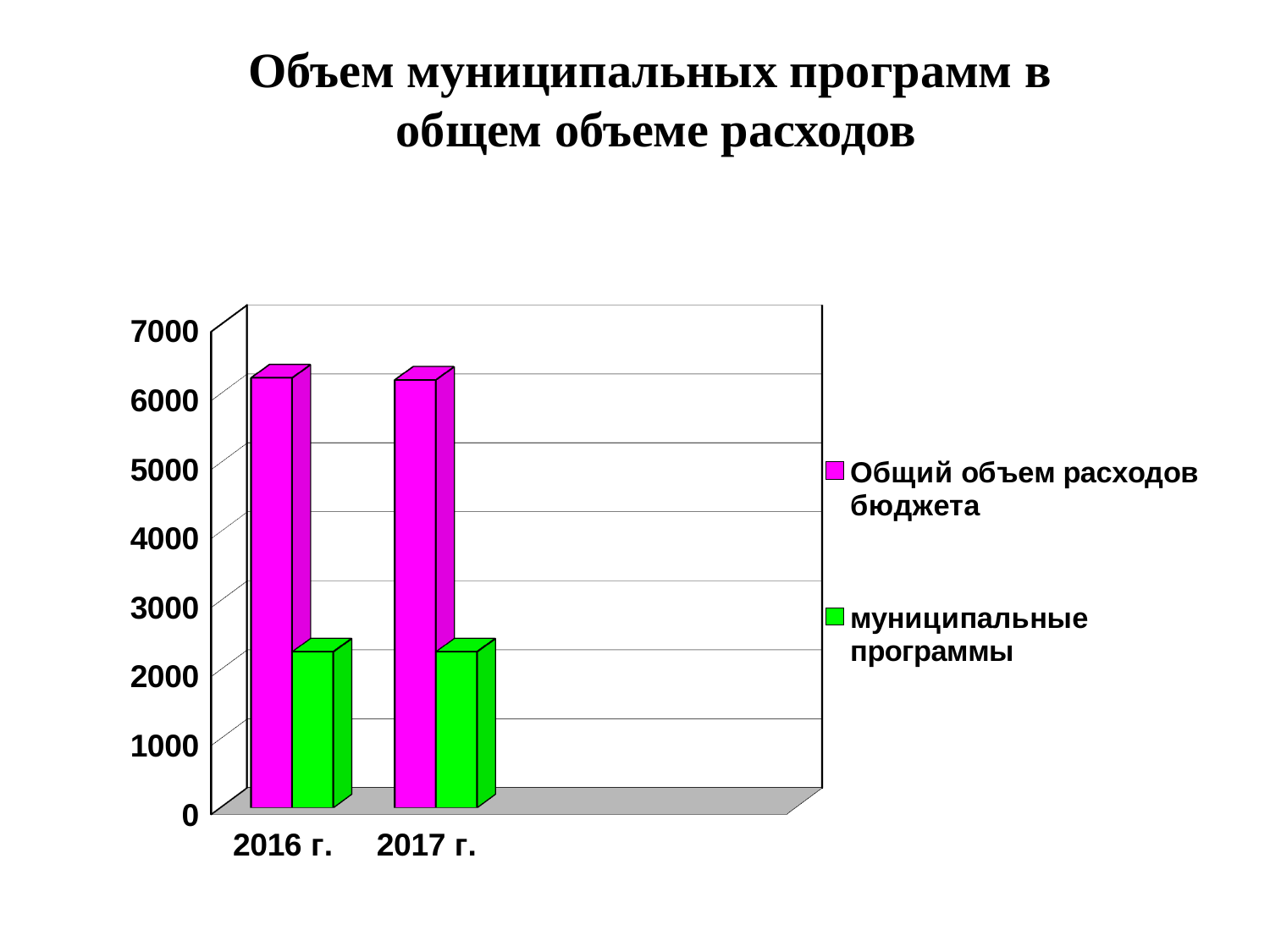
How many series does the legend list? 2 What kind of chart is shown on the slide? bar chart How many categories (years) are shown on the x axis? 2 In 2016 г., which is larger: Общий объем расходов бюджета or муниципальные программы? Общий объем расходов бюджета Is the value for муниципальные программы in 2017 г. greater or less than 1000? greater Is the value for Общий объем расходов бюджета in 2016 г. greater or less than 5000? greater Which series is shown in green? муниципальные программы Which two years are shown on the x axis? 2016 г. and 2017 г. Is the value for Общий объем расходов бюджета in 2017 г. greater or less than 5000? greater In 2017 г., which is larger: муниципальные программы or Общий объем расходов бюджета? Общий объем расходов бюджета What is the title of the chart? Объем муниципальных программ в общем объеме расходов